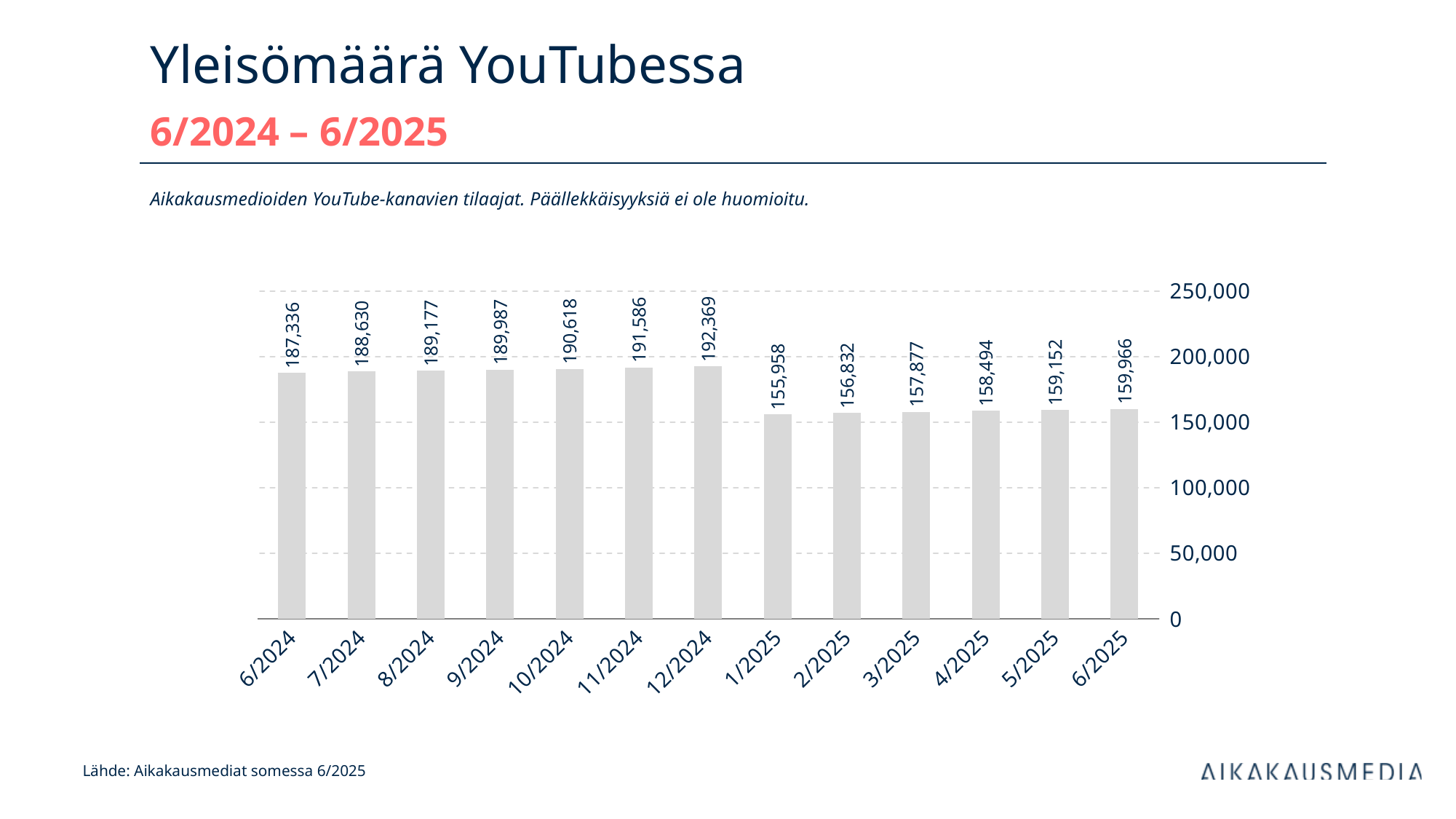
What is the value for 6/2025? 159,966 Is the value for 1/2025 greater or less than 200,000? less What is the difference between the values for 6/2024 and 6/2025? 27,370 What is the title of the slide? Yleisömäärä YouTubessa Which month has the lowest value? 1/2025 How many months are shown on the x axis? 13 What is the value for 1/2025? 155,958 Which month has the highest value? 12/2024 What is the difference between the values for 12/2024 and 1/2025? 36,411 Which is larger, the value for 11/2024 or the value for 5/2025? 11/2024 What kind of chart is shown on the slide? bar chart What is the value for 12/2024? 192,369